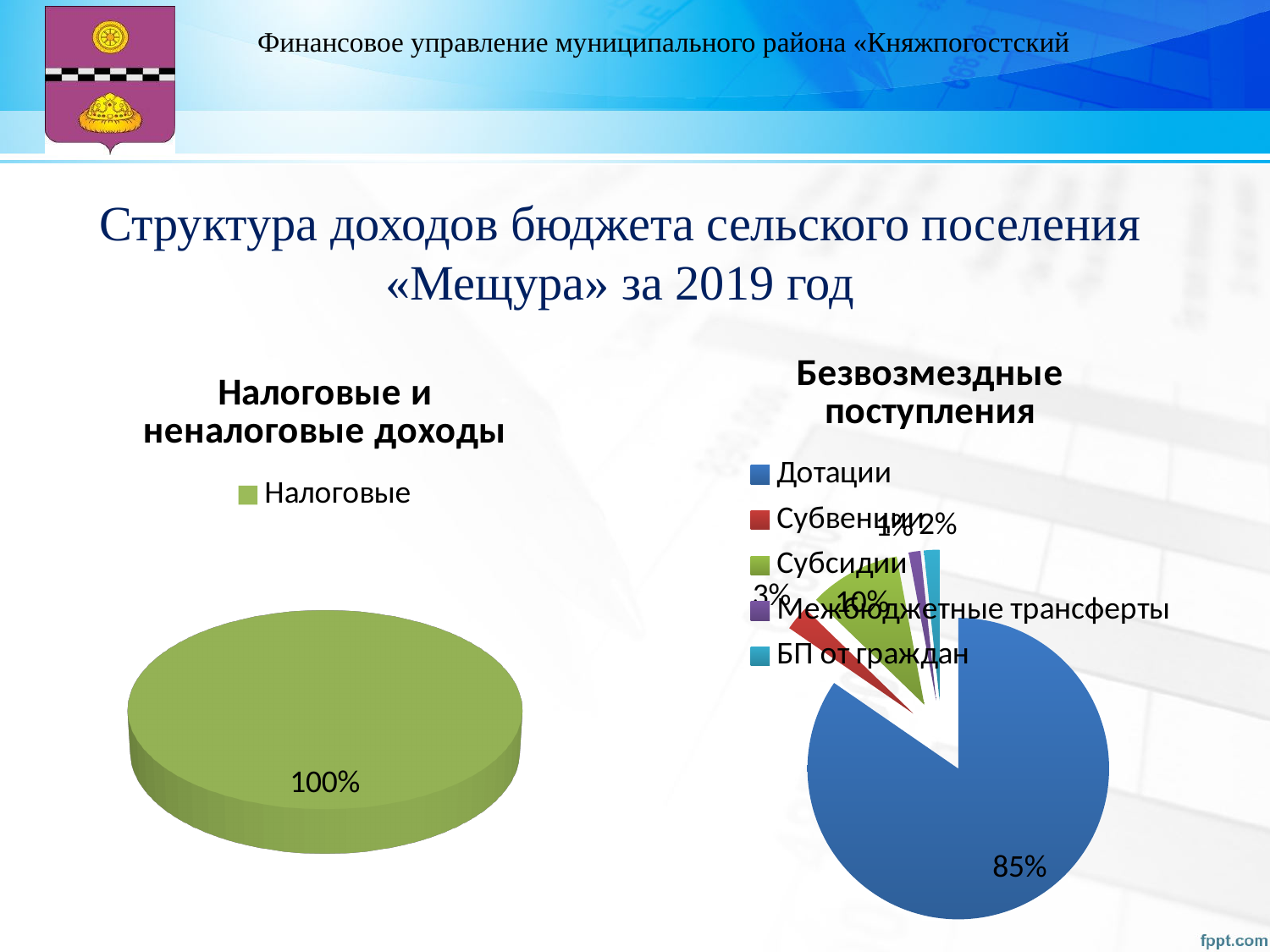
How many categories does the legend of the "Безвозмездные поступления" chart list? 5 In the "Безвозмездные поступления" chart, what share does Субсидии have? 10% In the "Безвозмездные поступления" chart, what share does Субвенции have? 3% In the "Налоговые и неналоговые доходы" chart, what share does Налоговые have? 100% What type of chart is the "Налоговые и неналоговые доходы" chart? pie chart In the "Безвозмездные поступления" chart, what is the difference between the shares of Дотации and Субсидии? 75% In the "Безвозмездные поступления" chart, which category has the largest share? Дотации In the "Безвозмездные поступления" chart, which is larger: Субсидии or Субвенции? Субсидии What type of chart is the "Безвозмездные поступления" chart? pie chart What colour is the Дотации slice in the "Безвозмездные поступления" chart? blue How many series does the legend of the "Налоговые и неналоговые доходы" chart list? 1